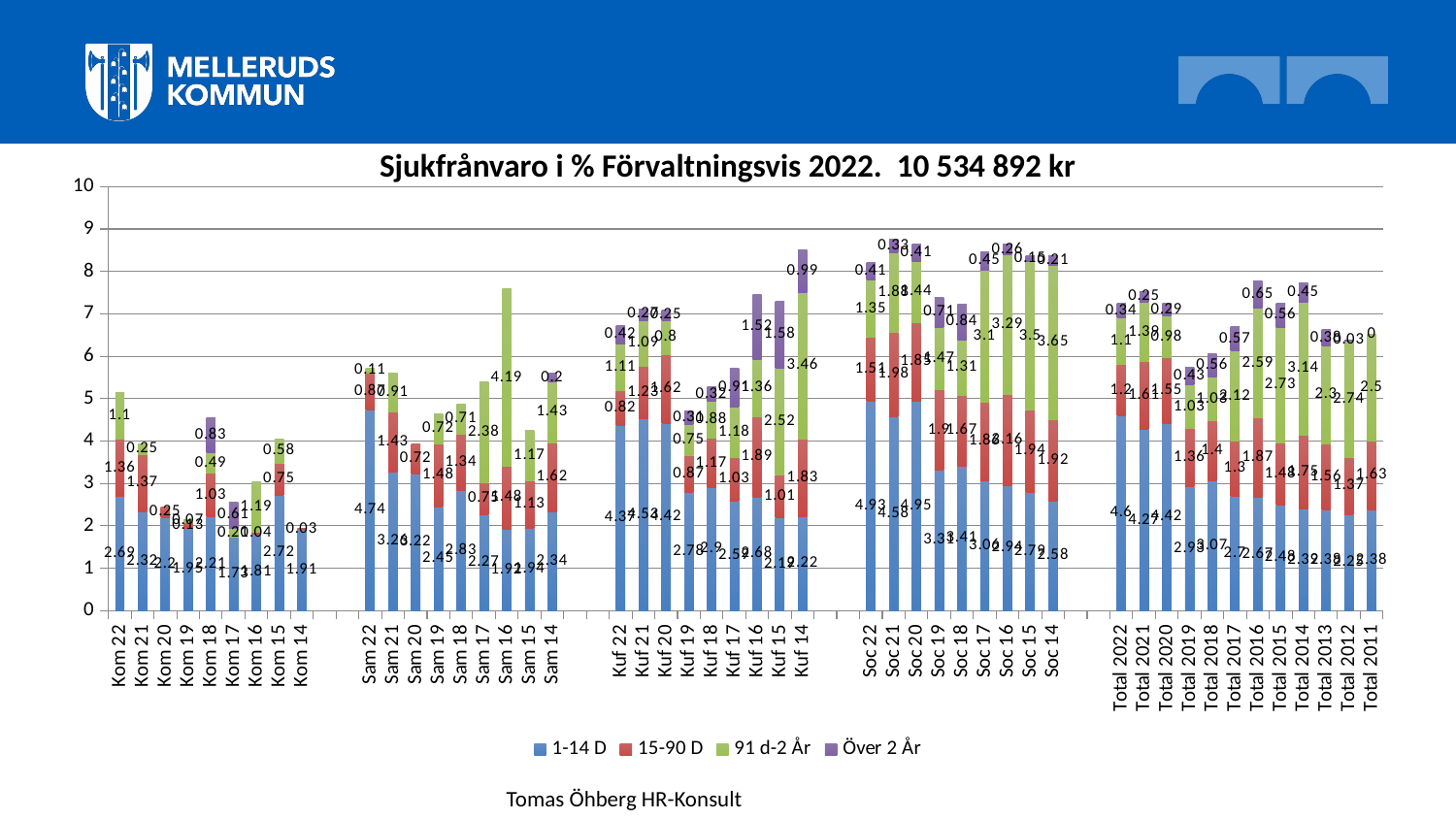
Is the total stacked value for Sam 16 greater or less than 7? greater What is the 1-14 D value for Soc 22? 4.93 What is the difference between the 1-14 D values for Soc 22 and Kuf 22? 0.56 How many series does the legend list? 4 What is the 91 d-2 År value for Sam 16? 4.19 What is the 1-14 D value for Total 2022? 4.6 Which has a larger total stacked value, Soc 22 or Kom 22? Soc 22 What is the title of the chart? Sjukfrånvaro i % Förvaltningsvis 2022. 10 534 892 kr What kind of chart is shown on the slide? Stacked bar chart Which bar is the lowest overall in the chart? Kom 14 What is the Över 2 År value for Kuf 14? 0.99 What is the 1-14 D value for Sam 22? 4.74